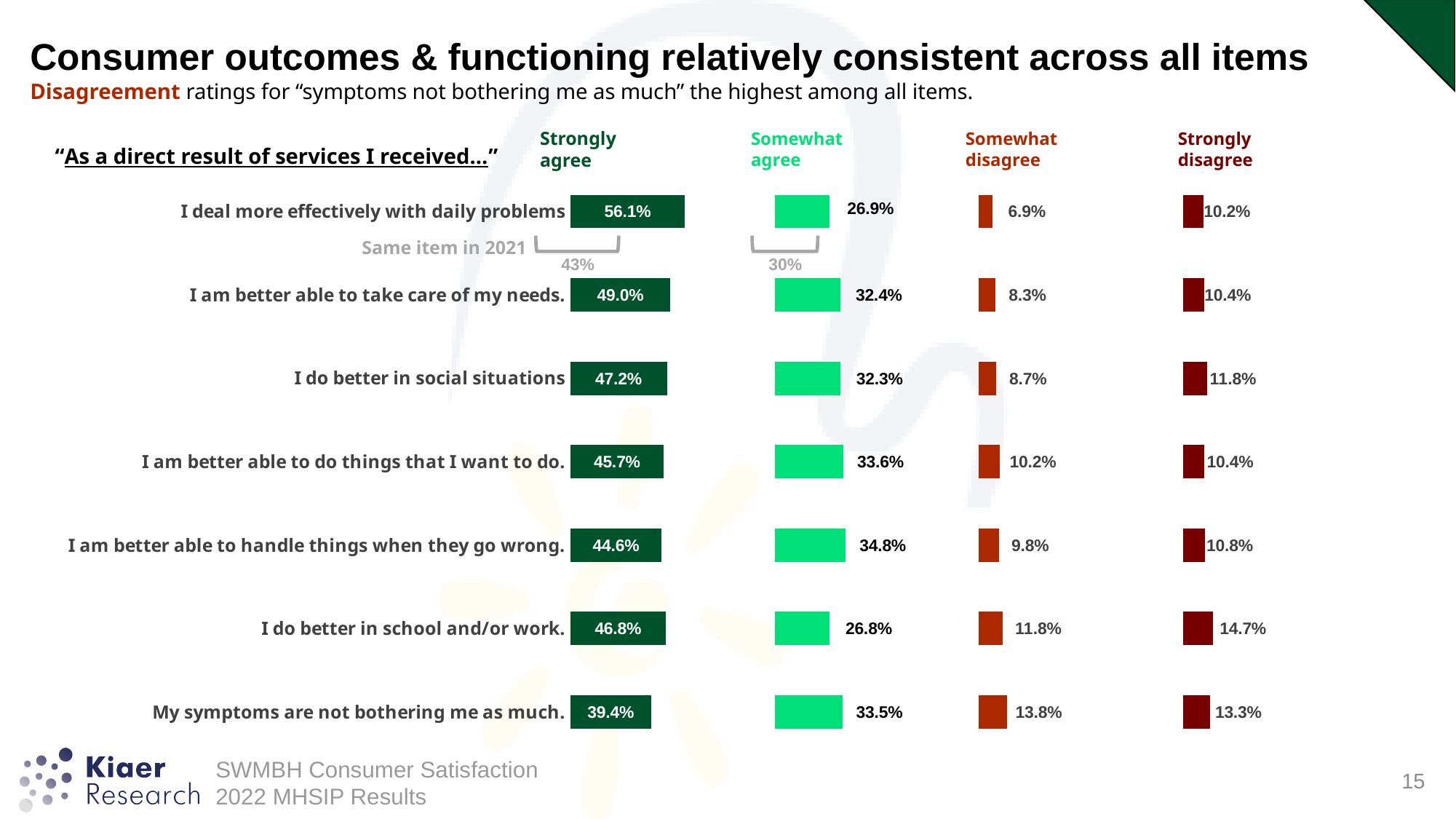
What was the strongly agree percentage for the same daily problems item in 2021? 43% What is the somewhat disagree percentage for "My symptoms are not bothering me as much"? 13.8% Which item has the highest somewhat agree percentage? I am better able to handle things when they go wrong. Which is larger: the strongly disagree percentage for "I do better in social situations" or for "I am better able to take care of my needs"? I do better in social situations How many survey items are shown in the chart? 7 Which item has the highest strongly agree percentage? I deal more effectively with daily problems Which item has the lowest strongly agree percentage? My symptoms are not bothering me as much. Which item has the highest somewhat disagree percentage? My symptoms are not bothering me as much. What percentage strongly agree with "I deal more effectively with daily problems"? 56.1% What is the difference in strongly agree percentage between "I deal more effectively with daily problems" and "My symptoms are not bothering me as much"? 16.7 percentage points How many response categories (series) does the chart show? 4 What is the strongly disagree percentage for "I do better in school and/or work"? 14.7%